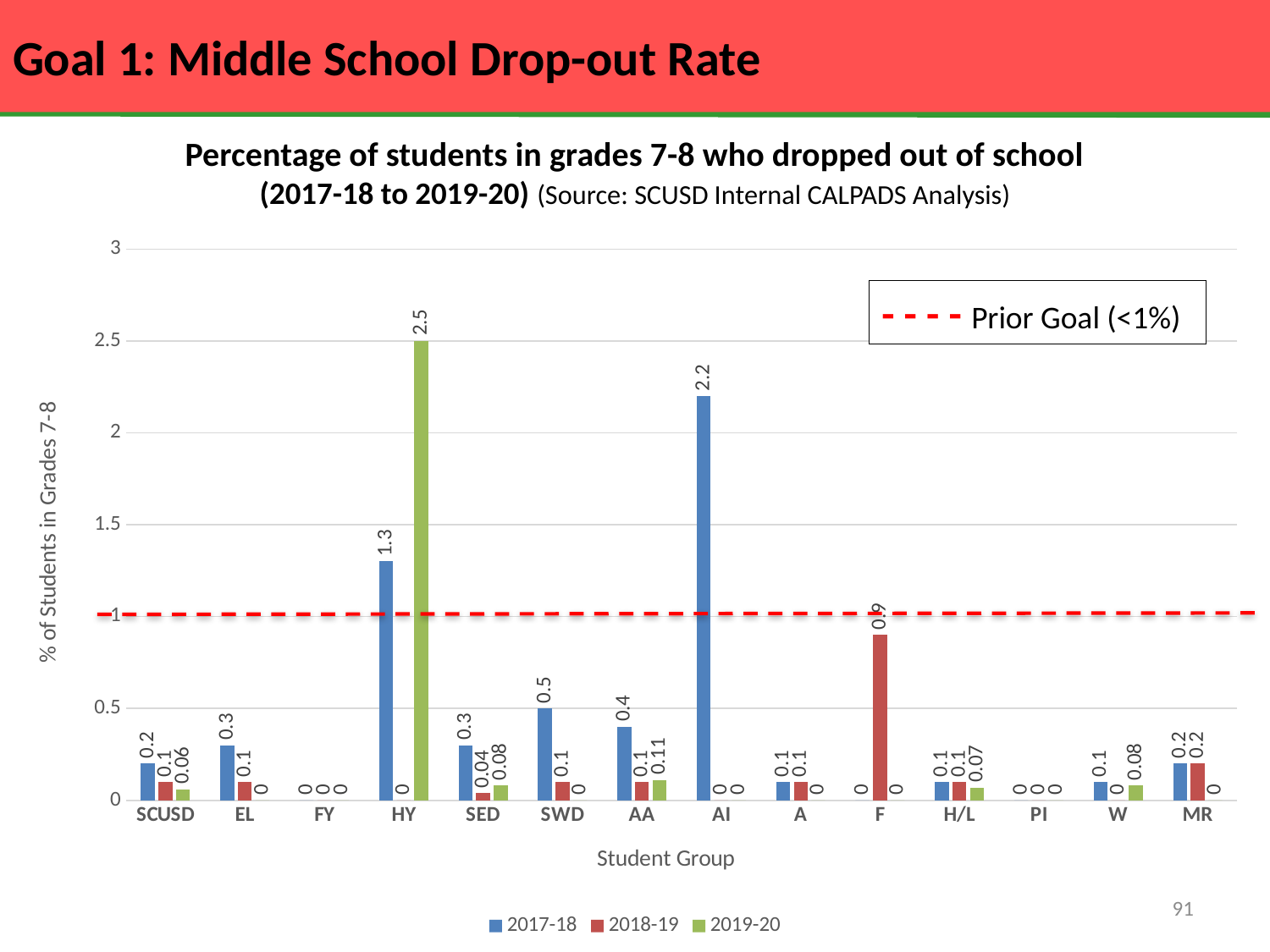
What is the value for HY in 2019-20? 2.5 What is the value for AI in 2017-18? 2.2 Which is larger in 2017-18: the value for HY or the value for AI? AI What is the difference between the HY values for 2019-20 and 2017-18? 1.2 Which student group has the highest value in the 2019-20 series? HY What kind of chart is shown on the slide? Bar chart How many student groups are shown on the x axis? 14 What is the value for SED in 2018-19? 0.04 What is the value for F in 2018-19? 0.9 What does the red dashed line on the chart represent? Prior Goal (<1%) How many series does the legend list? 3 Which student group has the highest value in the 2017-18 series? AI